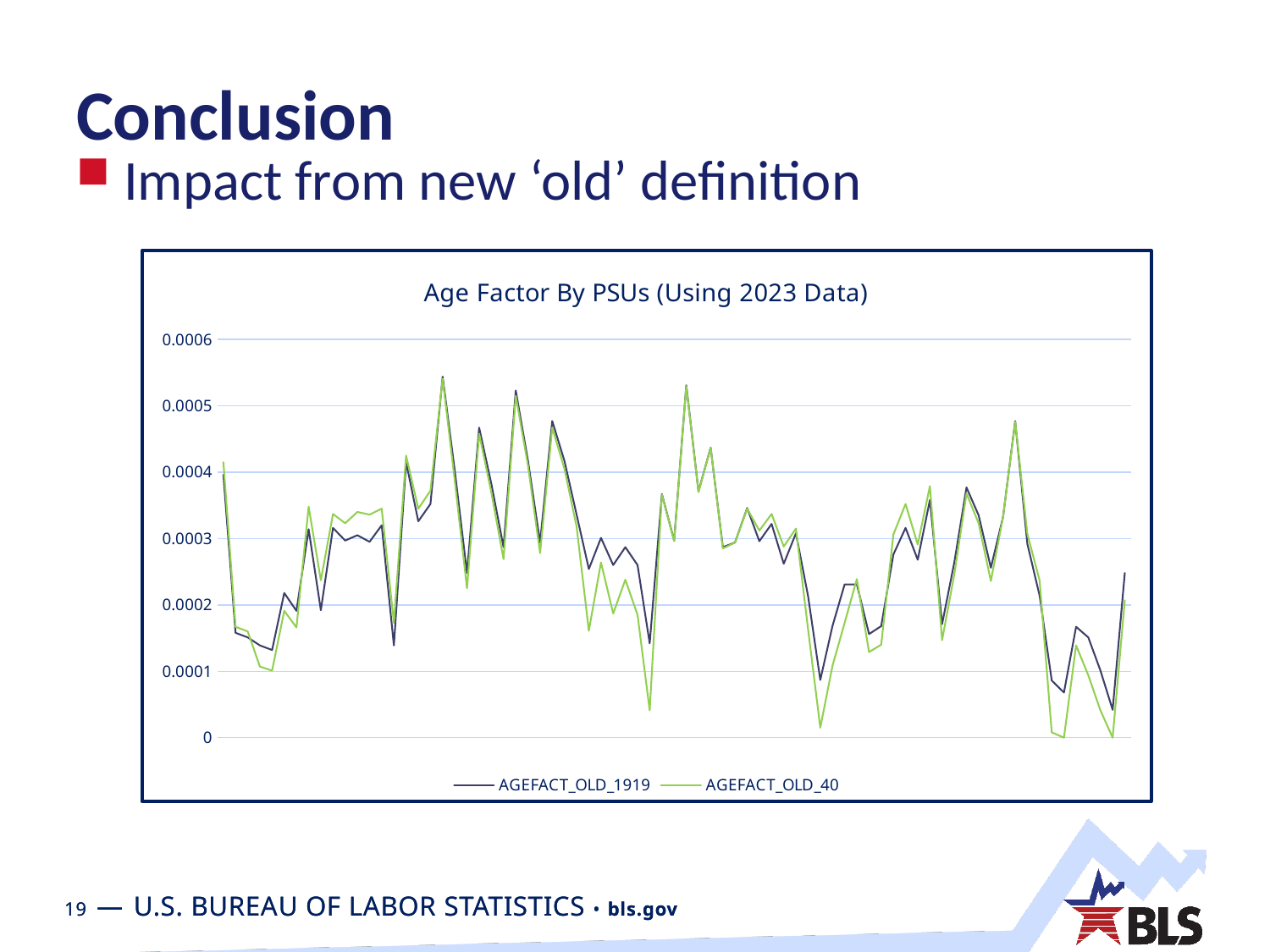
What is the title of the chart? Age Factor By PSUs (Using 2023 Data) Is the lowest value reached by the AGEFACT_OLD_40 series greater or less than 0.0001? less Is the lowest value reached by the AGEFACT_OLD_1919 series greater or less than 0.0001? less Is the highest value reached by the AGEFACT_OLD_1919 series greater or less than 0.0005? greater What is the lowest tick value shown on the y axis? 0 What is the highest tick value shown on the y axis? 0.0006 How many series does the legend list? 2 Which series is drawn in green? AGEFACT_OLD_40 What kind of chart is shown on the slide? line chart